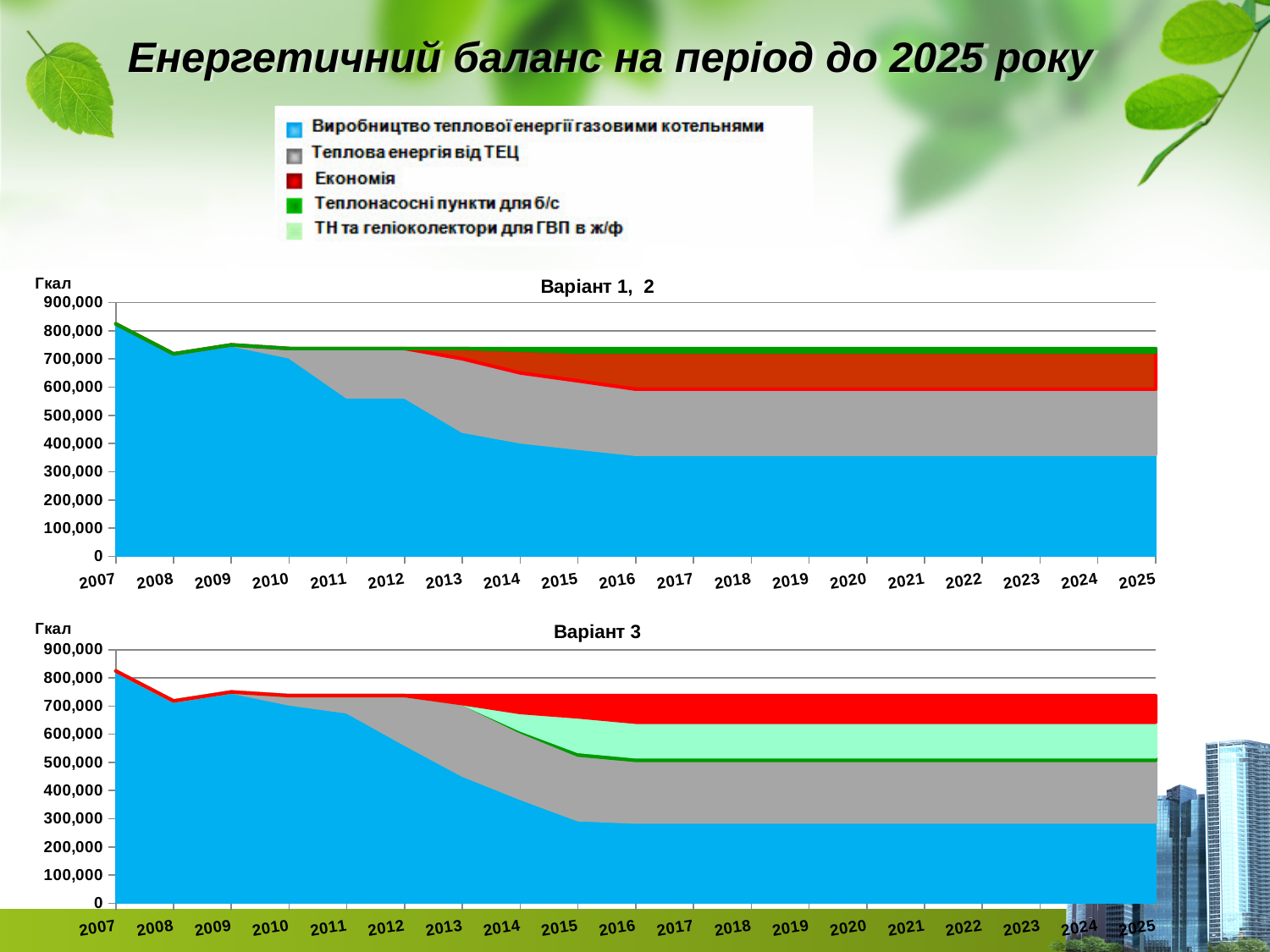
What kind of chart is the "Варіант 1, 2" chart? stacked area chart In the "Варіант 1, 2" chart, does the area for "Виробництво теплової енергії газовими котельнями" rise or fall from 2007 to 2025? fall What is the first year on the x axis of the "Варіант 1, 2" chart? 2007 How many series does the legend list? 5 How many charts are shown on the slide? 2 In the "Варіант 3" chart, does the area for "Виробництво теплової енергії газовими котельнями" rise or fall from 2007 to 2016? fall What unit is shown on the y axis of both charts? Гкал In the "Варіант 1, 2" chart, is the value for "Виробництво теплової енергії газовими котельнями" in 2025 greater or less than 400,000? less In 2025, is the value for "Виробництво теплової енергії газовими котельнями" larger in the "Варіант 1, 2" chart or in the "Варіант 3" chart? Варіант 1, 2 How many years are shown on the x axis of the "Варіант 3" chart? 19 In the "Варіант 3" chart, is the total stacked value in 2007 greater or less than 800,000? greater